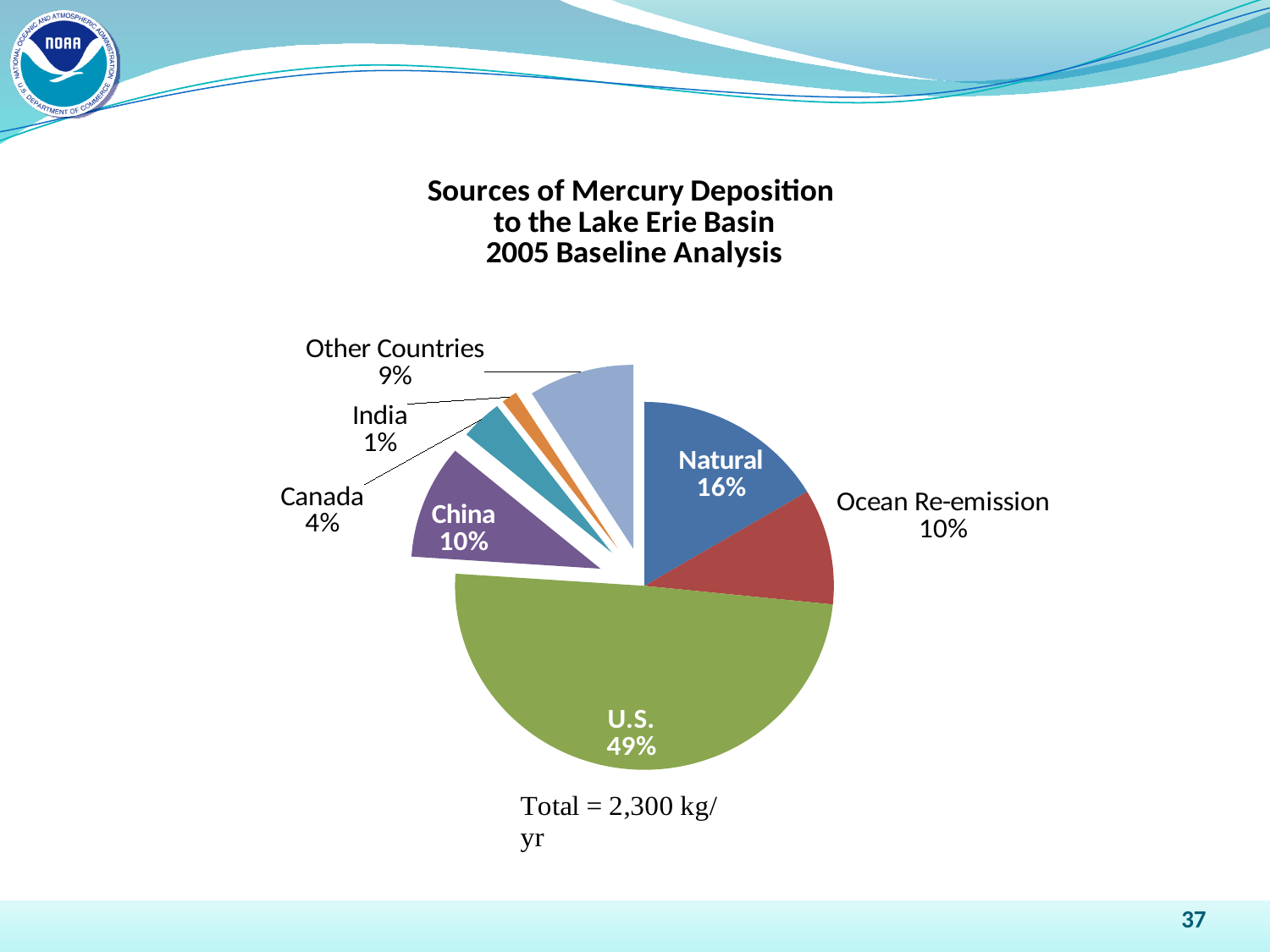
What percentage of the pie is attributed to Natural sources? 16% Which source has the smallest slice of the pie? India What total annual mercury deposition is stated below the chart? 2,300 kg/yr What type of chart is shown on the slide? Pie chart How many slices does the pie chart have? 7 Which is larger, the share for Canada or the share for Other Countries? Other Countries How many percentage points larger is the U.S. share than the Natural share? 33 What share is attributed to Other Countries? 9% What share does China contribute according to the pie chart? 10% What share of mercury deposition to the Lake Erie Basin comes from the U.S.? 49% Which source has the largest slice of the pie? U.S. What percentage is shown for Ocean Re-emission? 10%